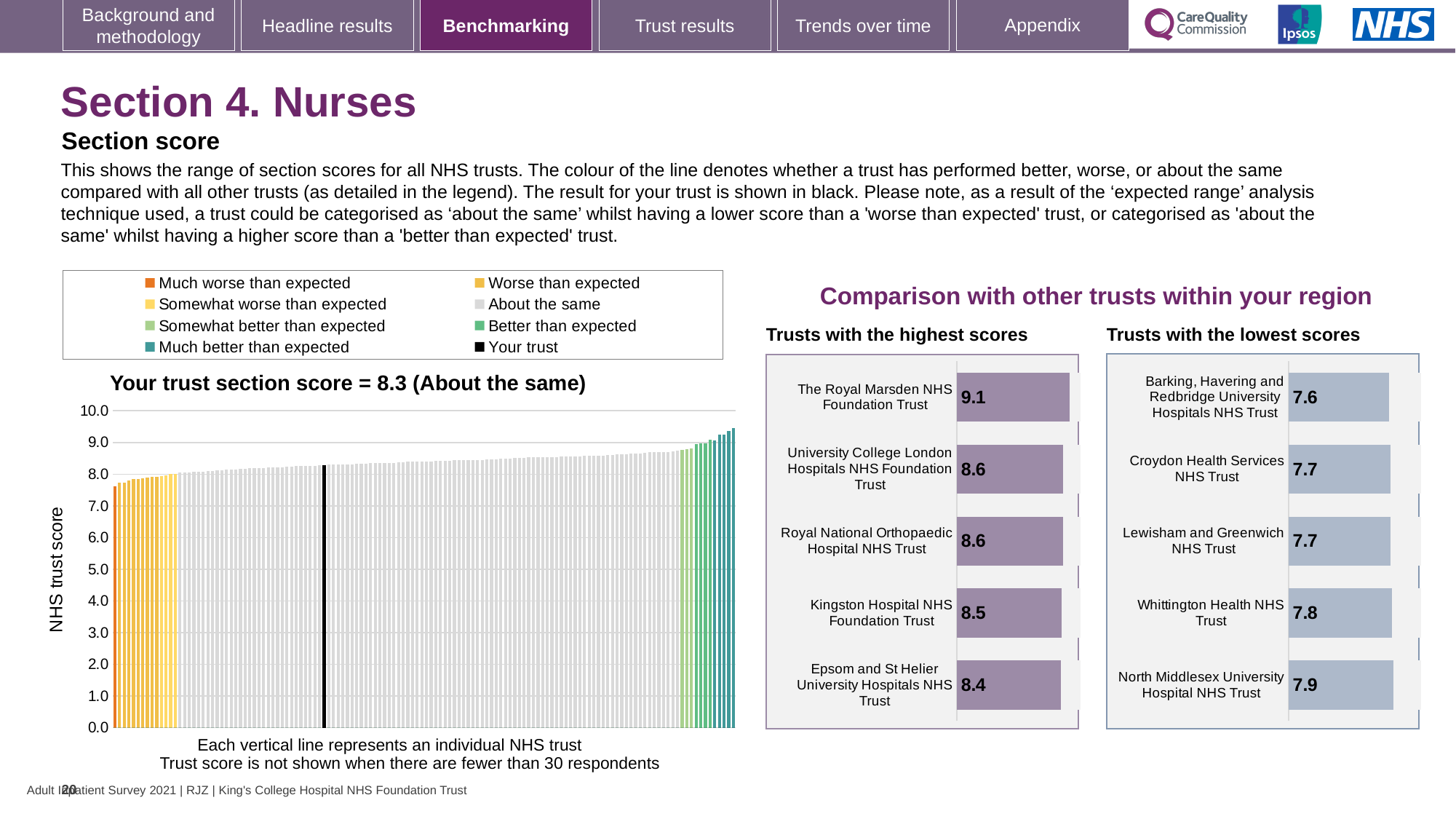
On the 'Your trust section score' chart, what kind of chart is shown? bar chart On the 'Trusts with the lowest scores' chart, which has the higher score: Whittington Health NHS Trust or Croydon Health Services NHS Trust? Whittington Health NHS Trust On the 'Trusts with the highest scores' chart, what is the score for The Royal Marsden NHS Foundation Trust? 9.1 On the 'Your trust section score' chart, is the value of the lowest (leftmost) bar greater or less than 8.0? less On the 'Trusts with the highest scores' chart, what is the difference between the scores of The Royal Marsden NHS Foundation Trust and Epsom and St Helier University Hospitals NHS Trust? 0.7 On the 'Your trust section score' chart, is the value of the highest (rightmost) bar greater or less than 9.0? greater On the 'Your trust section score' chart, what is the label of the vertical axis? NHS trust score On the 'Your trust section score' chart, how many entries does the legend list? 8 On the 'Trusts with the highest scores' chart, how many trusts are shown? 5 On the 'Trusts with the lowest scores' chart, what is the score for North Middlesex University Hospital NHS Trust? 7.9 On the 'Trusts with the lowest scores' chart, which trust has the lowest score? Barking, Havering and Redbridge University Hospitals NHS Trust On the 'Your trust section score' chart, what is the section score for your trust? 8.3